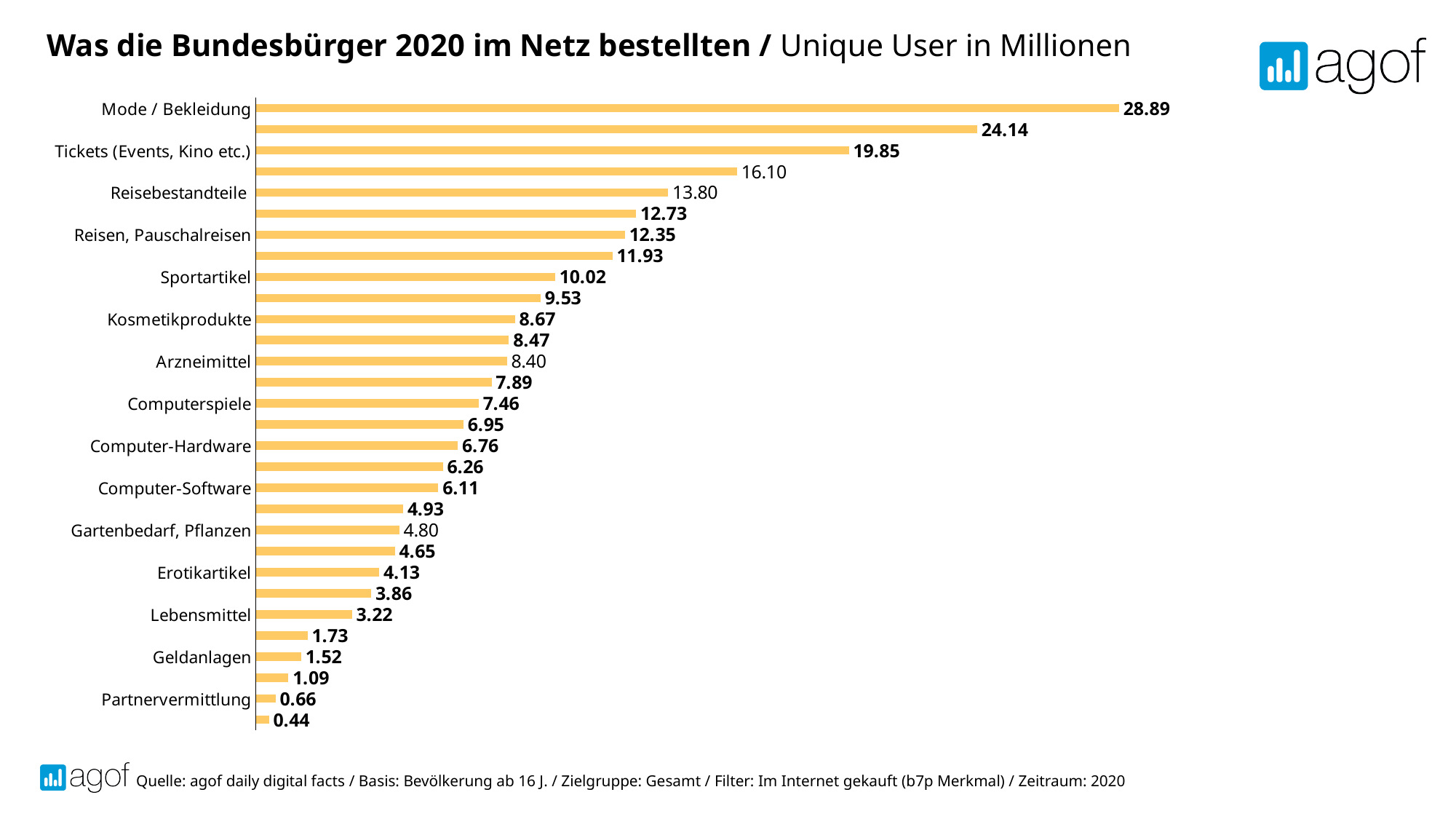
What is the difference between the values for Sportartikel and Kosmetikprodukte? 1.35 What is the value for Mode / Bekleidung? 28.89 What is the value for Tickets (Events, Kino etc.)? 19.85 What is the value for Computer-Hardware? 6.76 What is the smallest value printed on the chart? 0.44 How many bars are plotted on the chart? 30 Do the bar values increase or decrease from the top of the chart to the bottom? decrease Which labelled category has the highest value? Mode / Bekleidung What kind of chart is shown on the slide? bar chart Which is larger, the value for Reisebestandteile or for Reisen, Pauschalreisen? Reisebestandteile What is the difference between the values for Mode / Bekleidung and Tickets (Events, Kino etc.)? 9.04 What is the value for Partnervermittlung? 0.66